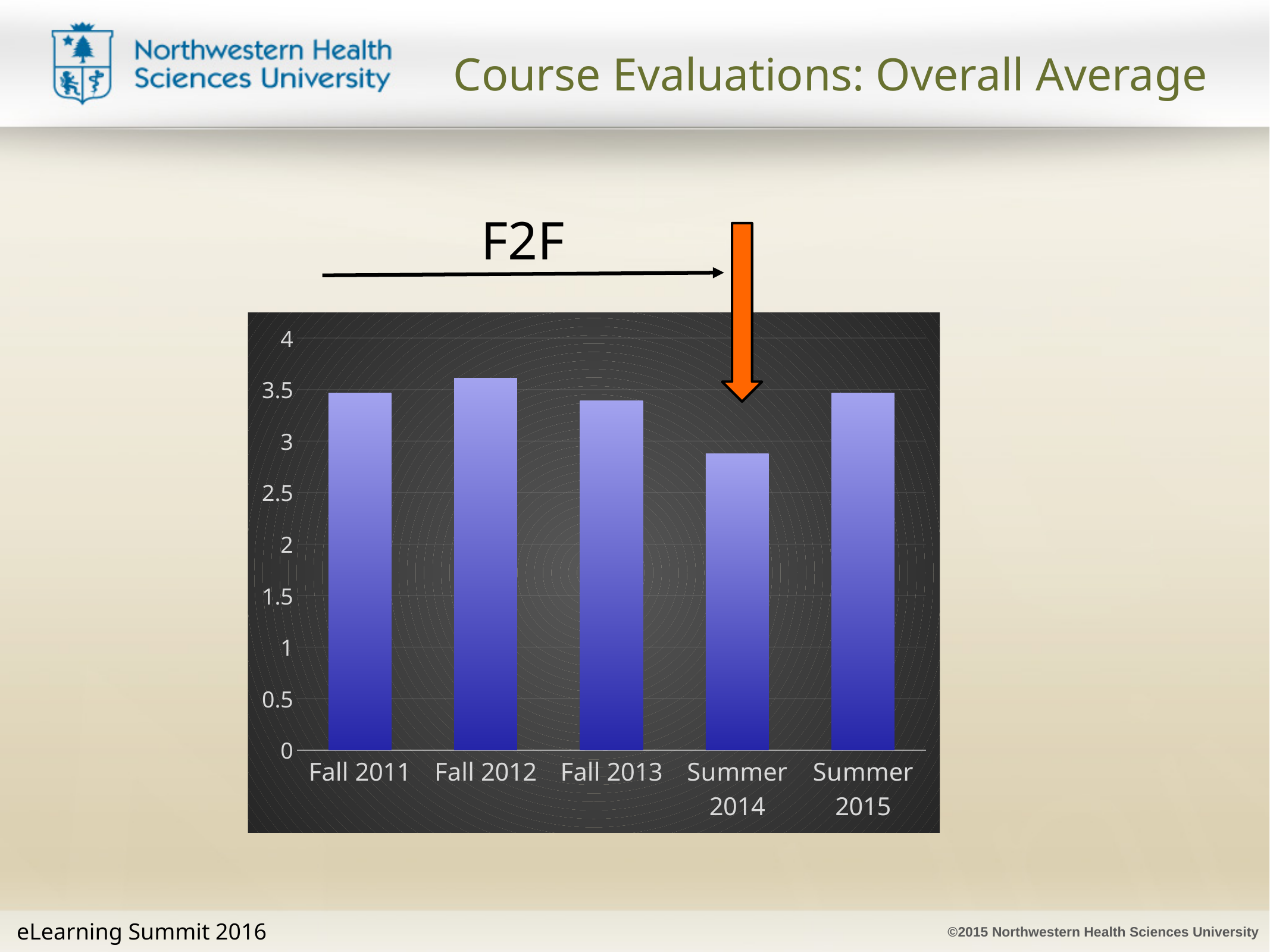
Is the value for Summer 2014 greater or less than 3? less Is the value for Fall 2013 greater or less than 3.5? less What is the title of the slide containing the chart? Course Evaluations: Overall Average How many categories (terms) are plotted on the chart? 5 What kind of chart is shown on the slide? bar chart Which term has the lowest overall average course evaluation? Summer 2014 Which is larger, the value for Fall 2012 or the value for Fall 2013? Fall 2012 Is the value for Fall 2012 greater or less than 3.5? greater What label appears above the horizontal arrow spanning the first three bars? F2F Which term has the highest overall average course evaluation? Fall 2012 Which is larger, the value for Fall 2013 or the value for Summer 2014? Fall 2013